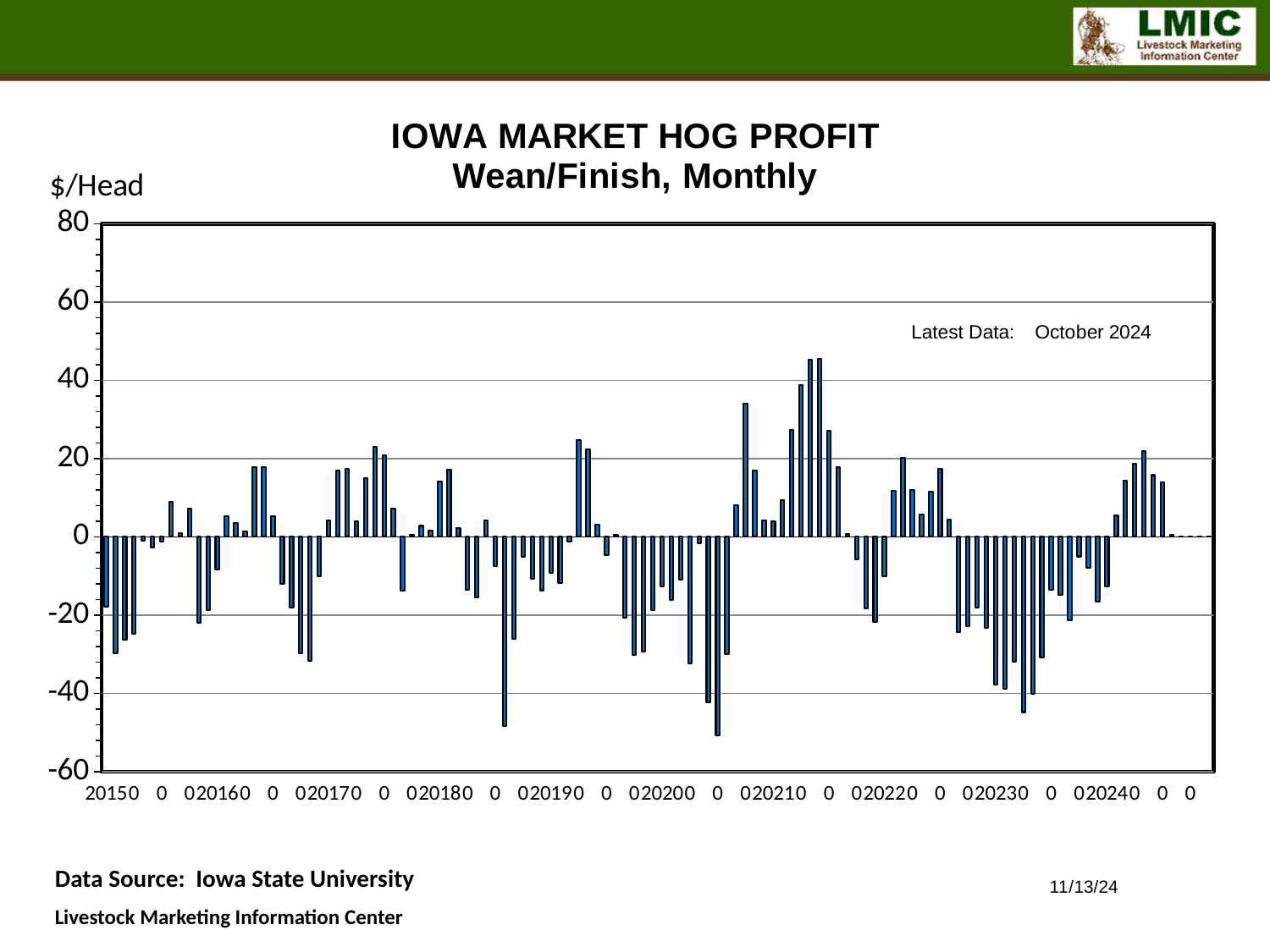
Is the value for the first bar of 2015 greater or less than -10? less Is the lowest value in 2023 greater or less than -30? less What unit is shown on the vertical axis of the chart? $/Head What is the title of the chart? IOWA MARKET HOG PROFIT Wean/Finish, Monthly What kind of chart is shown on the slide? bar chart Which year contains the tallest positive bar on the chart, 2021 or 2024? 2021 According to the note on the chart, what is the latest data month shown? October 2024 Is the lowest value plotted on the chart greater or less than -40? less What is the data source listed below the chart? Iowa State University